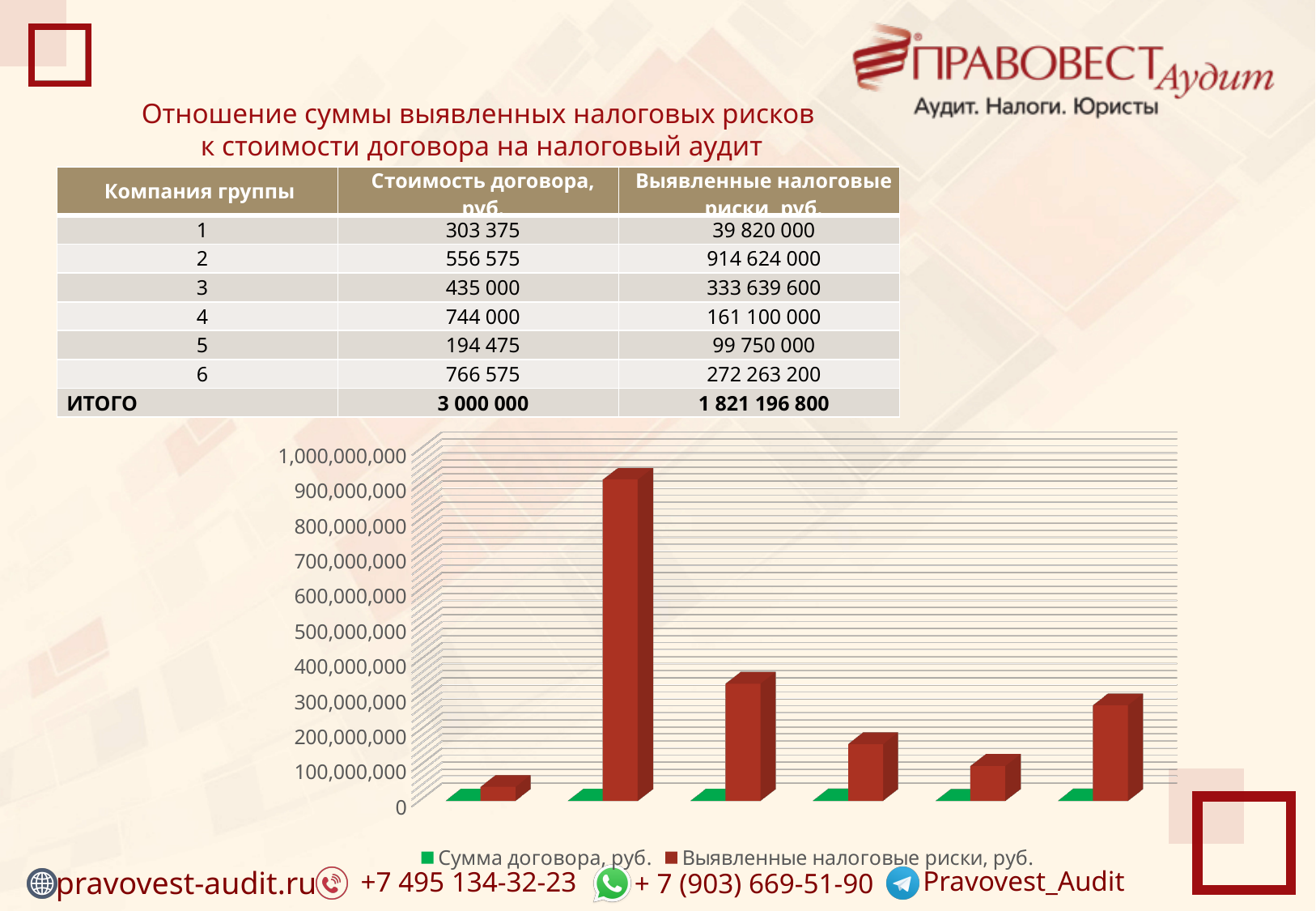
Is the value of the sixth red bar from the left greater or less than 200,000,000? greater What kind of chart is shown on the slide? bar chart Which group of bars has the shortest red bar (Выявленные налоговые риски)? the first from the left Is the value of the second red bar from the left greater or less than 800,000,000? greater Which group of bars has the tallest red bar (Выявленные налоговые риски)? the second from the left Which is larger: the third red bar from the left or the sixth red bar from the left? the third from the left Is the value of the third red bar from the left greater or less than 400,000,000? less What are the two series named in the chart legend? Сумма договора, руб. and Выявленные налоговые риски, руб. How many groups of bars are plotted in the chart? 6 What colour represents the series 'Сумма договора, руб.' in the chart? green How many series does the chart legend list? 2